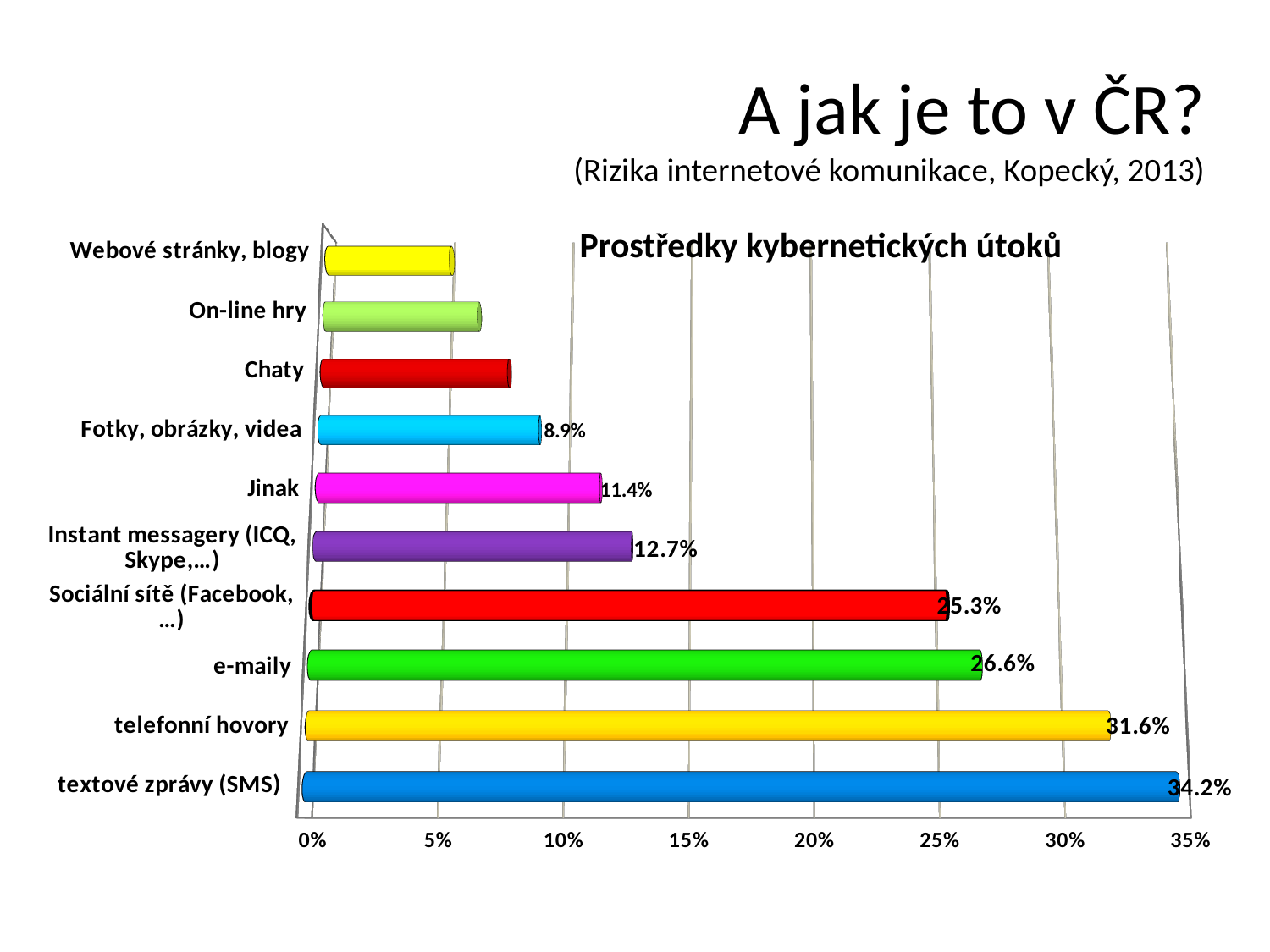
How many categories are shown in the chart? 10 What is the value for Sociální sítě (Facebook, …)? 25.3% Which category has the lowest value? Webové stránky, blogy What is the value for Jinak? 11.4% Which is larger, the value for e-maily or the value for Sociální sítě (Facebook, …)? e-maily Is the value for Chaty greater or less than 10%? less What is the title of the chart? Prostředky kybernetických útoků What kind of chart is shown on the slide? bar chart What is the difference between the values for textové zprávy (SMS) and telefonní hovory? 2.6 percentage points What is the value for textové zprávy (SMS)? 34.2% Which category has the highest value? textové zprávy (SMS)